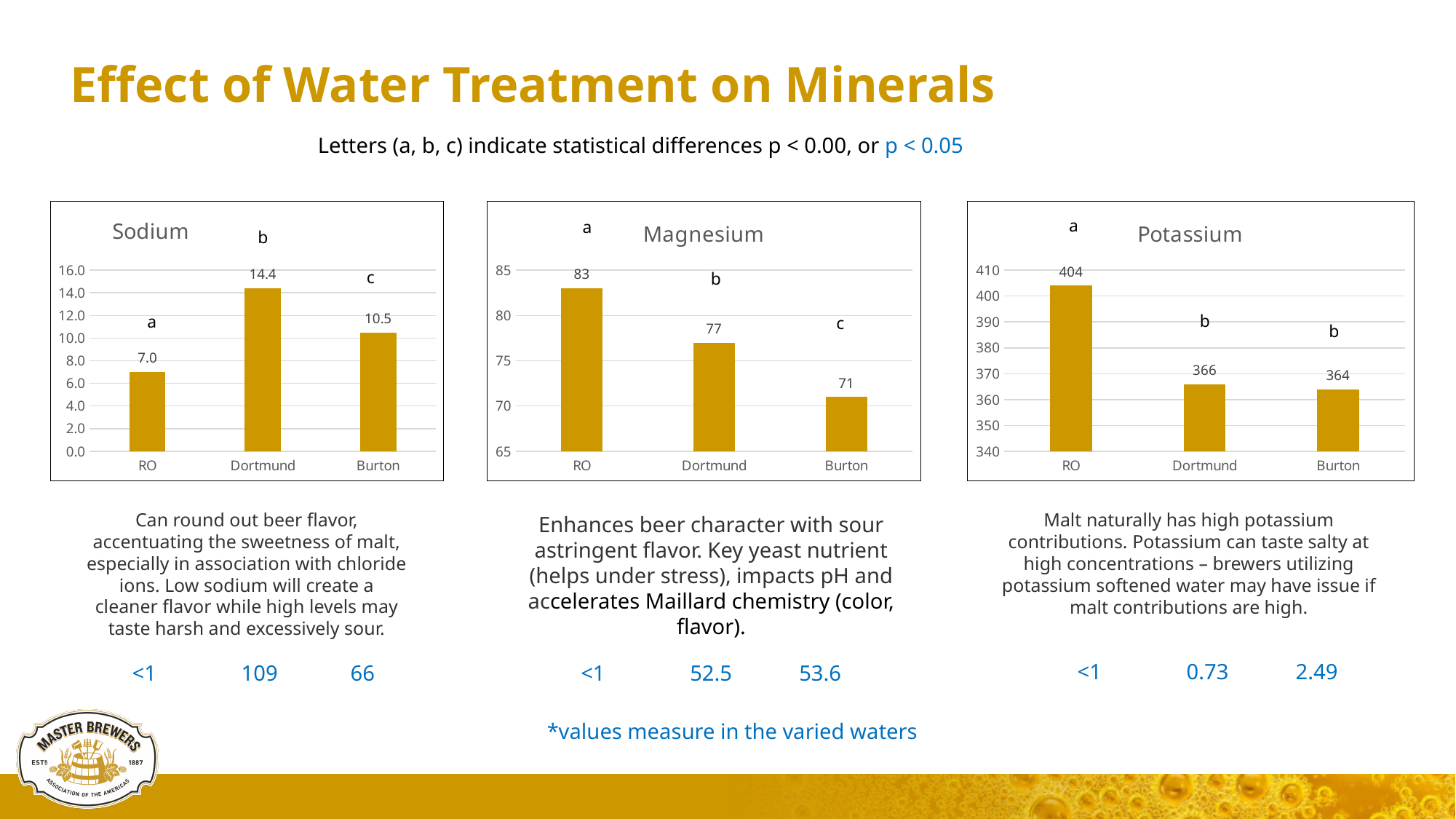
In the Potassium chart, is the value for Dortmund larger or smaller than the value for RO? smaller In the Potassium chart, what is the difference between the RO and Burton values? 40 In the Potassium chart, what is the value for RO? 404 In the Magnesium chart, what is the value for Burton? 71 What kind of chart is the Magnesium chart? bar chart How many categories are shown in the Sodium chart? 3 In the Magnesium chart, what is the difference between the RO and Dortmund values? 6 In the Magnesium chart, do the values rise or fall from RO to Burton? fall In the Sodium chart, which category has the lowest value? RO In the Sodium chart, what is the value for Dortmund? 14.4 In the Magnesium chart, which category has the highest value? RO In the Sodium chart, what is the difference between the Dortmund and Burton values? 3.9